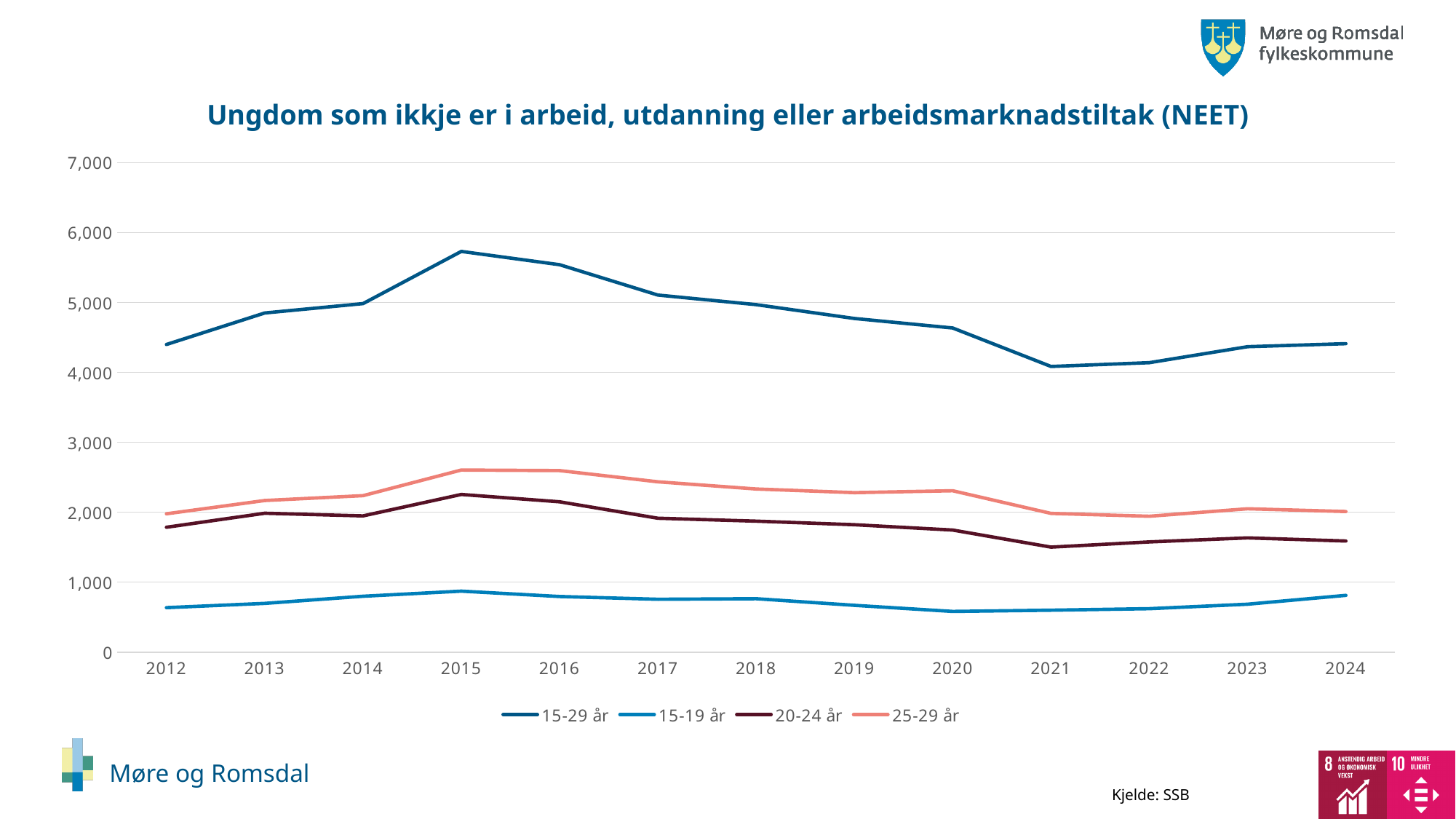
How many series does the legend list? 4 What kind of chart is shown on the slide? line chart In which year does the 20-24 år series reach its highest value? 2015 Is the value for 15-29 år in 2015 greater or less than 5,000? greater Does the 15-29 år series rise or fall between 2015 and 2021? fall In which year does the 20-24 år series reach its lowest value? 2021 Which is larger for the 15-29 år series: the value in 2012 or the value in 2015? 2015 In which year does the 15-29 år series reach its highest value? 2015 How many years are plotted along the x axis? 13 Is the value for 15-19 år in 2015 greater or less than 1,000? less Is the value for 20-24 år in 2021 greater or less than 2,000? less What is the title of the chart? Ungdom som ikkje er i arbeid, utdanning eller arbeidsmarknadstiltak (NEET)